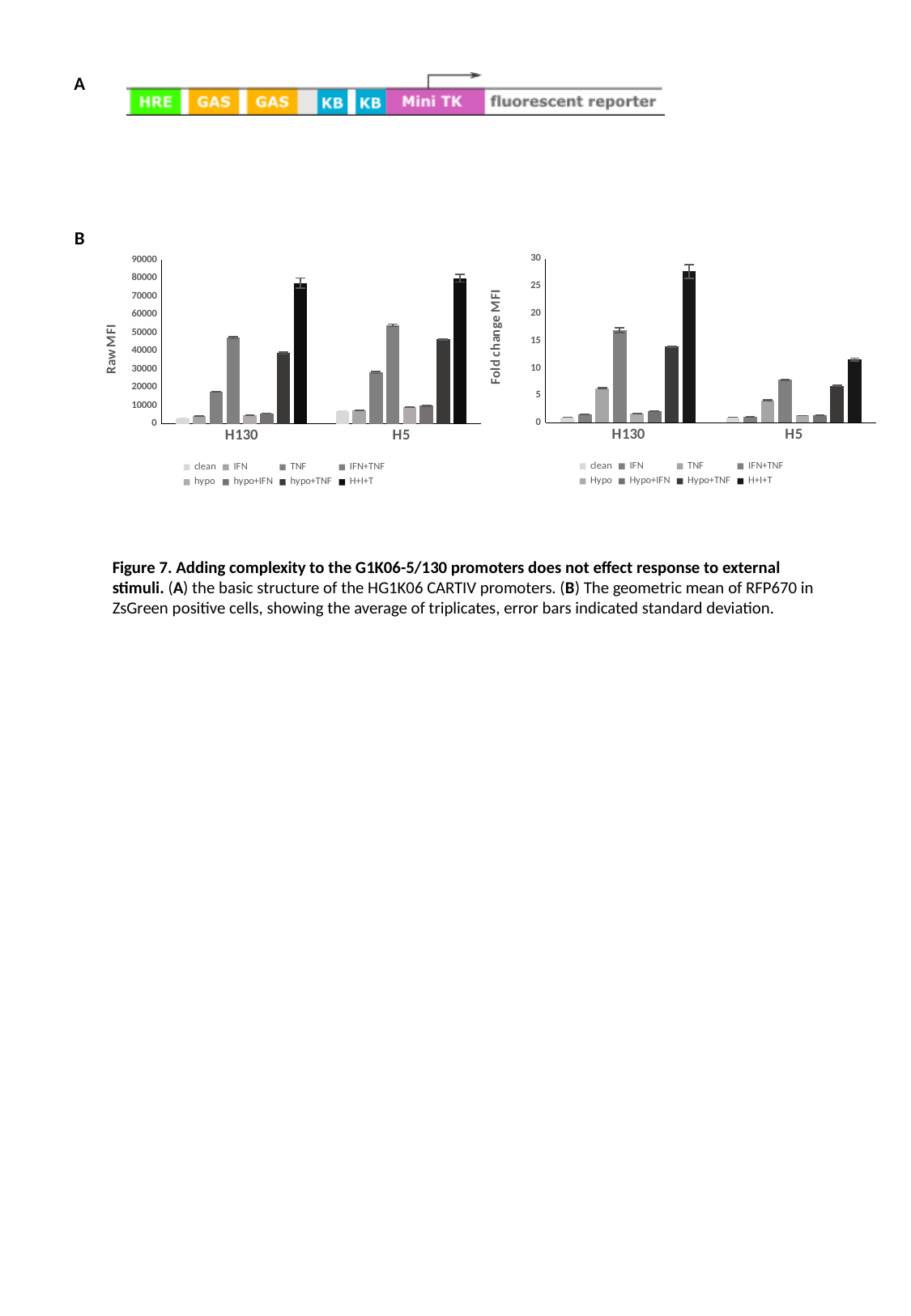
In the left chart (Raw MFI), which series has the highest value for H130? H+I+T How many series does the legend of the right chart (Fold change MFI) list? 8 How many promoter categories are shown on the x axis of the left chart (Raw MFI)? 2 In the right chart (Fold change MFI), is the TNF value for H5 greater or less than 5? less In the right chart (Fold change MFI), is the H+I+T value larger for H130 or for H5? H130 In the right chart (Fold change MFI), which series has the highest value for H5? H+I+T In the left chart (Raw MFI), is the TNF value larger for H130 or for H5? H5 In the right chart (Fold change MFI), is the H+I+T value for H130 greater or less than 25? greater In the left chart (Raw MFI), is the IFN value for H130 greater or less than 20000? less What is the y-axis title of the right chart in panel B? Fold change MFI What kind of chart is the left chart in panel B (Raw MFI)? bar chart